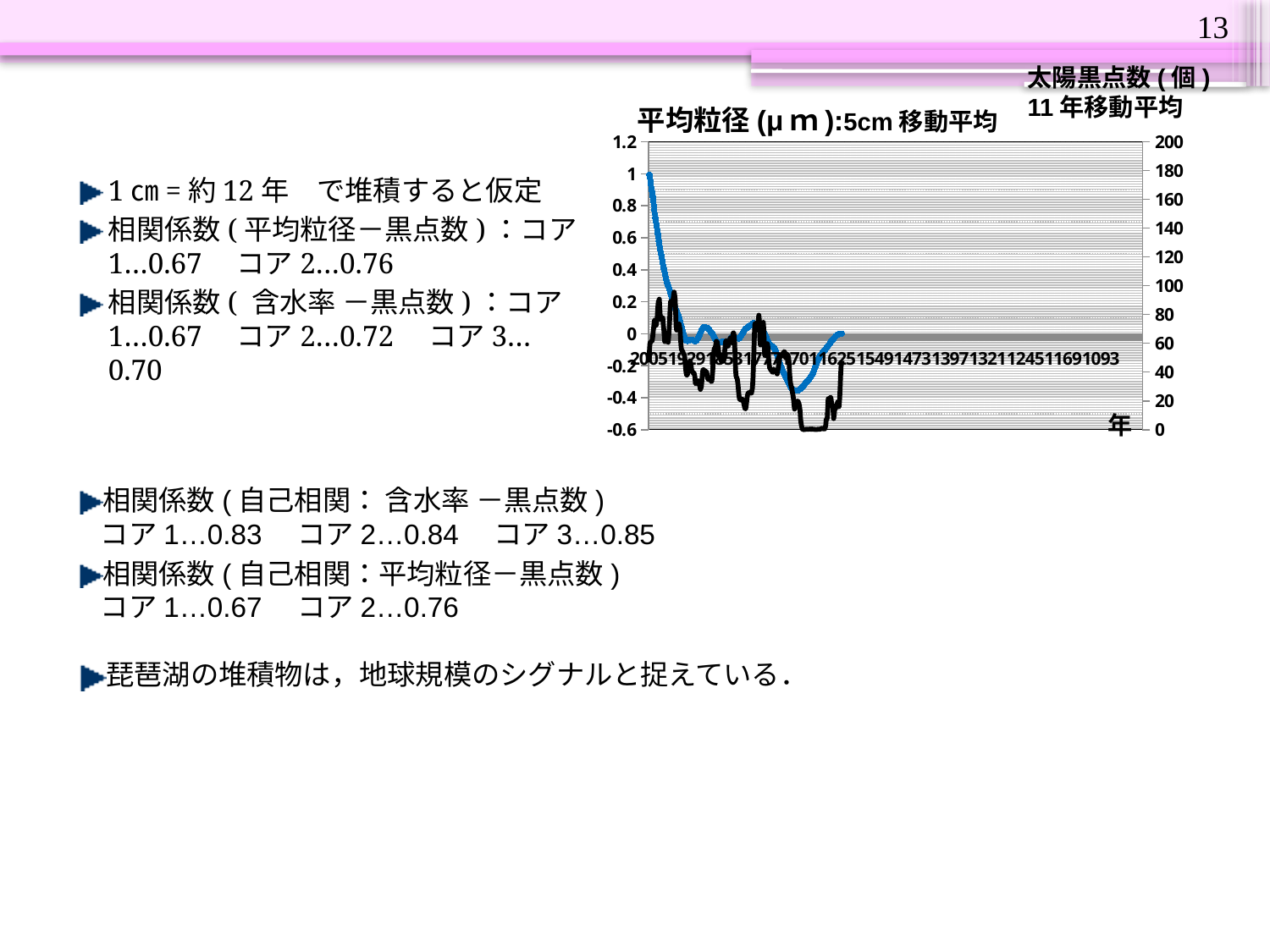
How many lines are plotted on the chart? 2 Is the lowest point of the black line on the chart greater or less than -0.4? less Which line reaches the higher value on the left axis scale, the blue line or the black line? the blue line What is the first year label at the left end of the x axis of the chart? 2005 What kind of chart is shown on the slide? line chart Does the blue line rise or fall from the left edge of the chart toward the middle? fall What is the title of the chart on the slide? 平均粒径(μm):5cm移動平均 What label is shown above the right-hand axis of the chart? 太陽黒点数(個) 11年移動平均 What is the maximum value shown on the left vertical axis of the chart? 1.2 Is the value of the blue line at the far left of the chart greater or less than 0.8? greater What is the minimum value shown on the left vertical axis of the chart? -0.6 What is the maximum value shown on the right vertical axis of the chart? 200